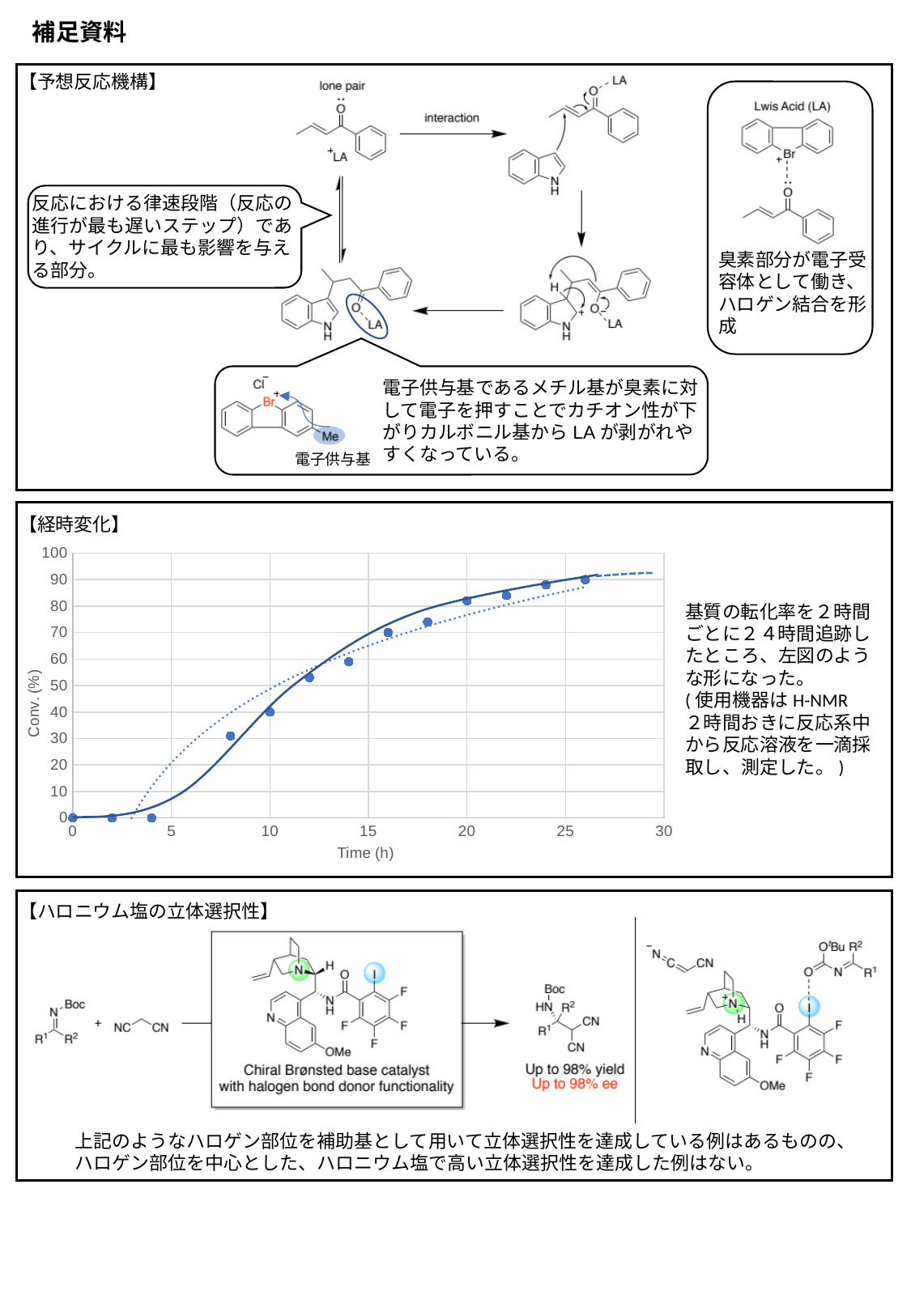
Is the conversion value at 8 h greater or less than 40? less Is the conversion value at 4 h greater or less than 10? less What is the title of the x axis of the conversion chart? Time (h) At which time point is the plotted conversion highest? 26 h What is the title of the y axis of the conversion chart? Conv. (%) Is the conversion value at 24 h greater or less than 70? greater Which has the larger conversion value, the point at 10 h or the point at 20 h? 20 h Do the plotted conversion values rise or fall as time increases? rise What kind of chart is shown in the 【経時変化】 section? scatter chart What is the maximum value shown on the y axis of the conversion chart? 100